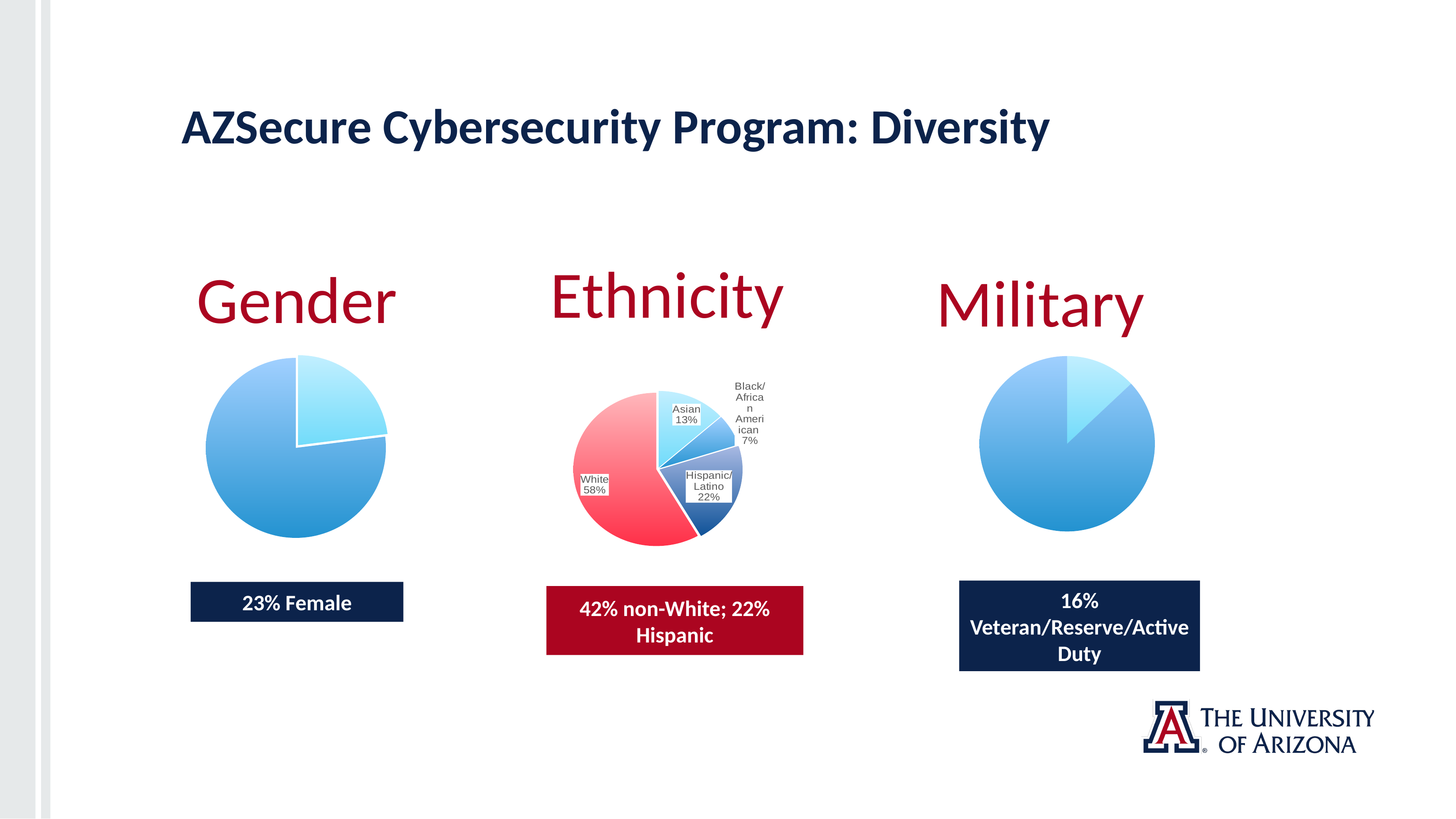
In the Ethnicity chart, what share is labelled White? 58% In the Ethnicity chart, what share is labelled Black/African American? 7% In the Ethnicity chart, what share is labelled Asian? 13% In the Ethnicity chart, which is larger, the Asian slice or the Hispanic/Latino slice? Hispanic/Latino In the Ethnicity chart, how many slices does the pie have? 4 In the Ethnicity chart, which category has the largest slice? White How many pie charts are shown on the slide? 3 What kind of chart is the Ethnicity chart? pie chart In the Ethnicity chart, what is the difference between the White and Hispanic/Latino shares? 36% In the Ethnicity chart, what share is labelled Hispanic/Latino? 22% What kind of chart is the Gender chart? pie chart In the Ethnicity chart, which category has the smallest slice? Black/African American